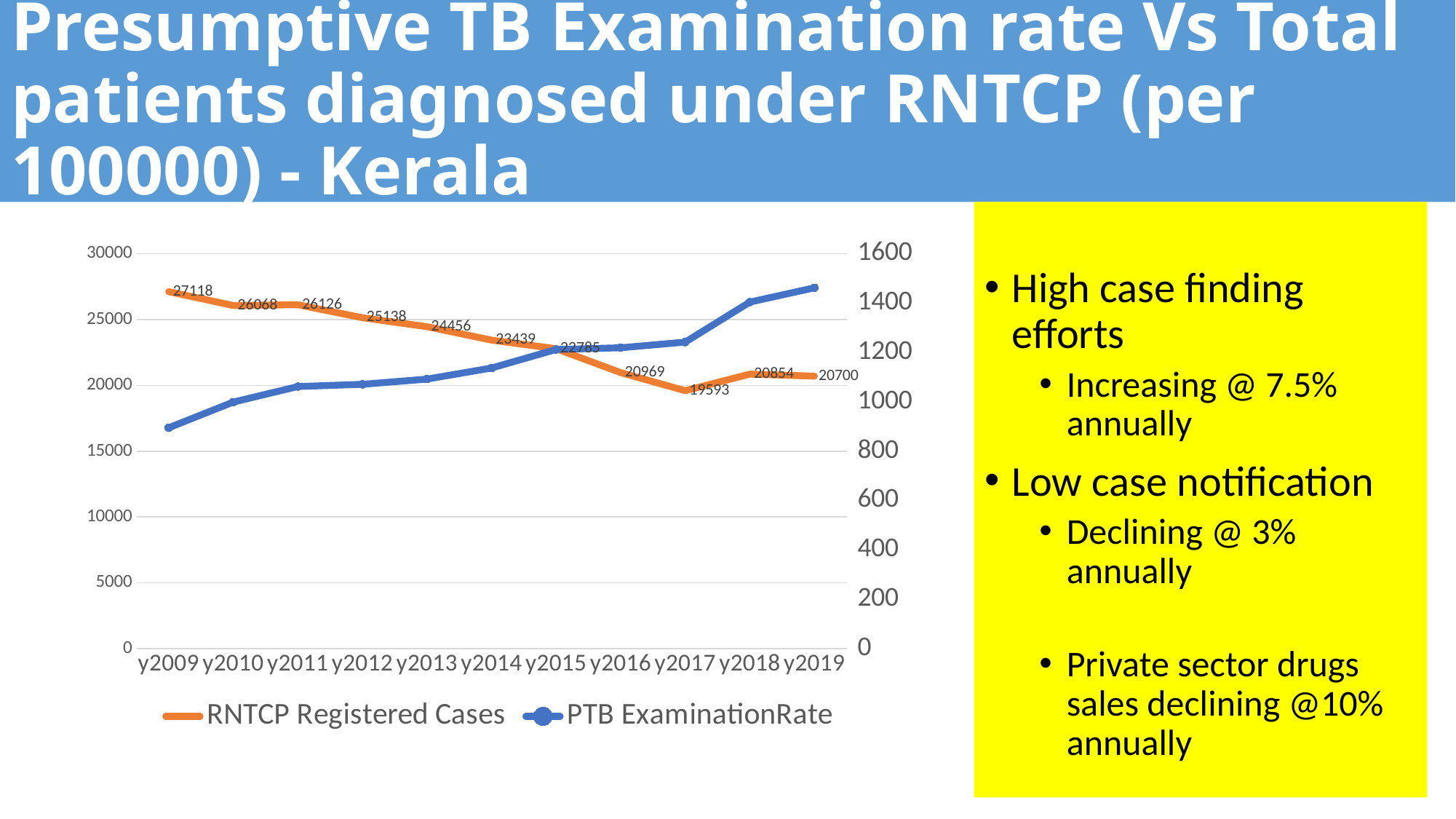
Which is larger, RNTCP Registered Cases in y2010 or y2011? y2011 How many series does the legend list? 2 Is the PTB Examination Rate for y2019 greater or less than 1400? greater What is the value of RNTCP Registered Cases for y2017? 19593 In which year is the RNTCP Registered Cases value highest? y2009 What is the difference between RNTCP Registered Cases in y2009 and y2019? 6418 How many years are shown on the x axis? 11 What is the value of RNTCP Registered Cases for y2009? 27118 What is the value of RNTCP Registered Cases for y2019? 20700 Is the PTB Examination Rate for y2009 greater or less than 1000? less In which year is the RNTCP Registered Cases value lowest? y2017 What kind of chart is shown on the slide? line chart